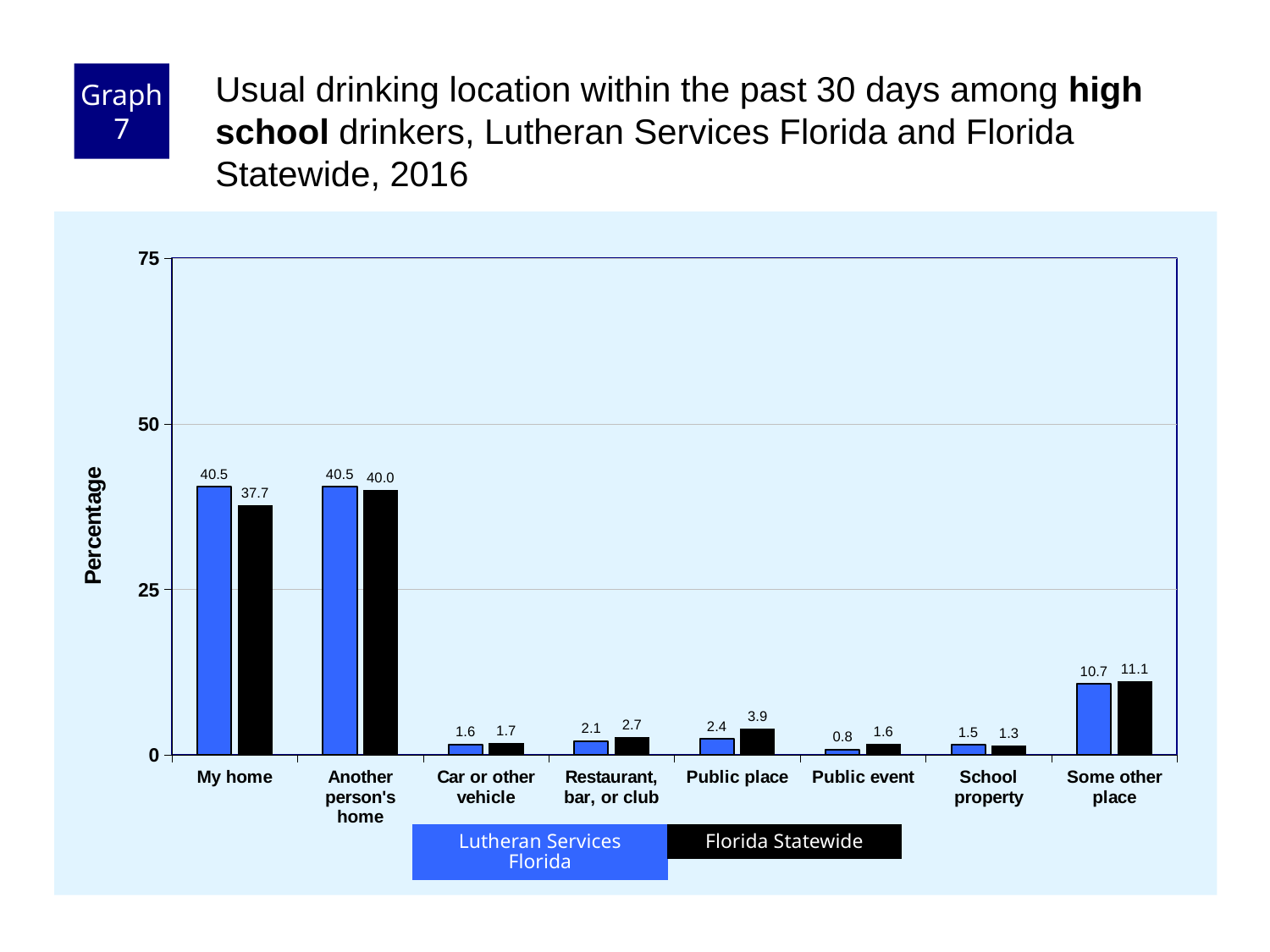
Is the Lutheran Services Florida value for Some other place greater or less than 25? less Which is larger for School property: Lutheran Services Florida or Florida Statewide? Lutheran Services Florida What is the Florida Statewide value for Some other place? 11.1 Which category has the lowest Lutheran Services Florida value? Public event What is the difference between the Florida Statewide and Lutheran Services Florida values for Public place? 1.5 What kind of chart is shown on the slide? bar chart How many series does the legend list? 2 What is the Lutheran Services Florida value for Public place? 2.4 How many categories are shown on the x axis? 8 Which category has the highest Florida Statewide value? Another person's home What is the difference between the Lutheran Services Florida and Florida Statewide values for My home? 2.8 What is the Florida Statewide value for My home? 37.7